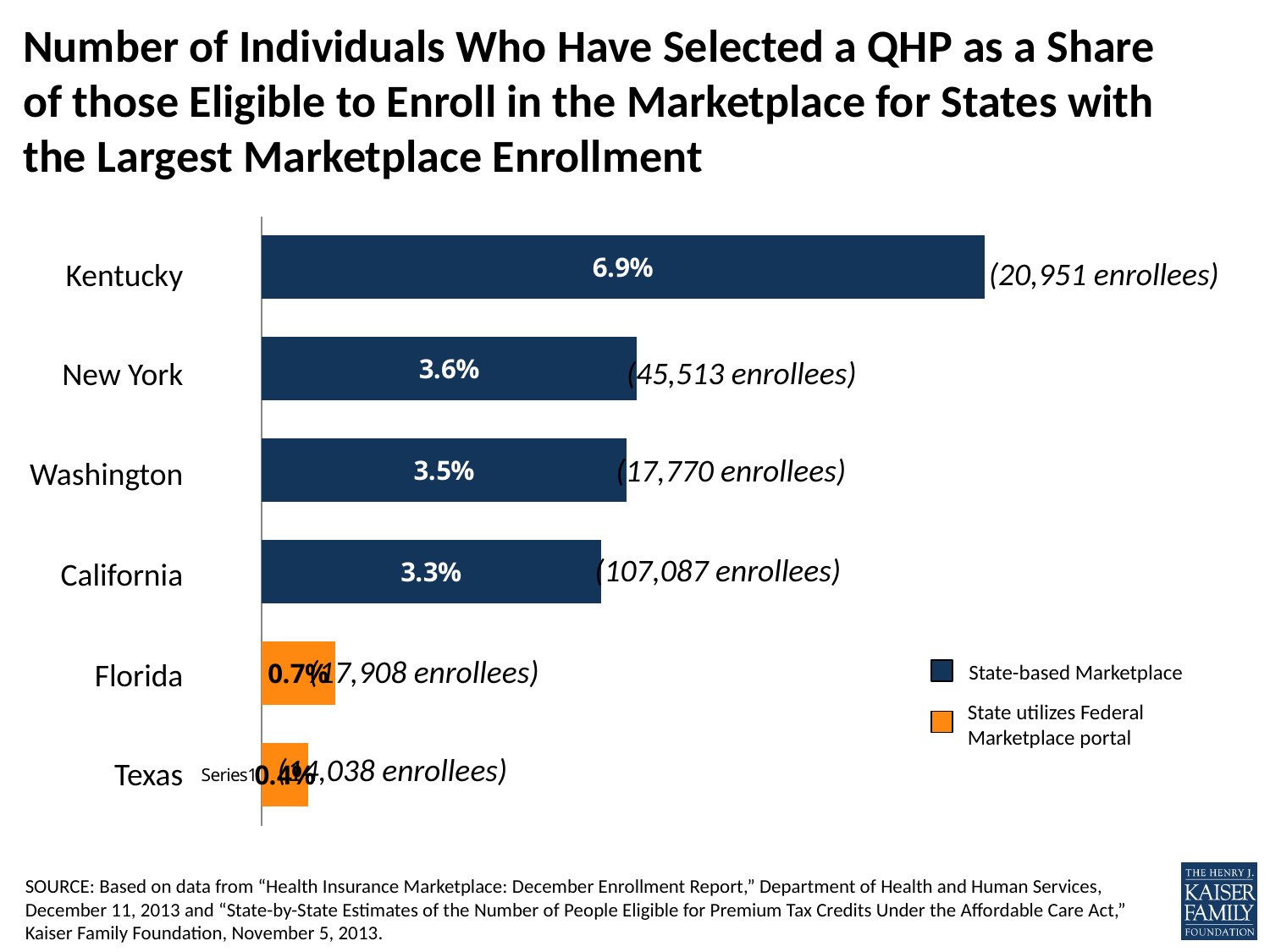
What is the difference in percentage points between Kentucky's share and New York's share? 3.3 percentage points How many states are shown in the chart? 6 Which state has the highest share of eligible individuals who selected a QHP? Kentucky How many entries does the legend list? 2 What share of eligible individuals selected a QHP in Kentucky? 6.9% How many enrollees does the chart report for California? 107,087 enrollees Which states are shown in orange as utilizing the Federal Marketplace portal? Florida and Texas Which state has the lowest share of eligible individuals who selected a QHP? Texas Do the percentage values increase or decrease going from the top bar to the bottom bar? Decrease Which has a larger share, New York or Washington? New York What share of eligible individuals selected a QHP in Washington? 3.5% What kind of chart is shown on the slide? Bar chart